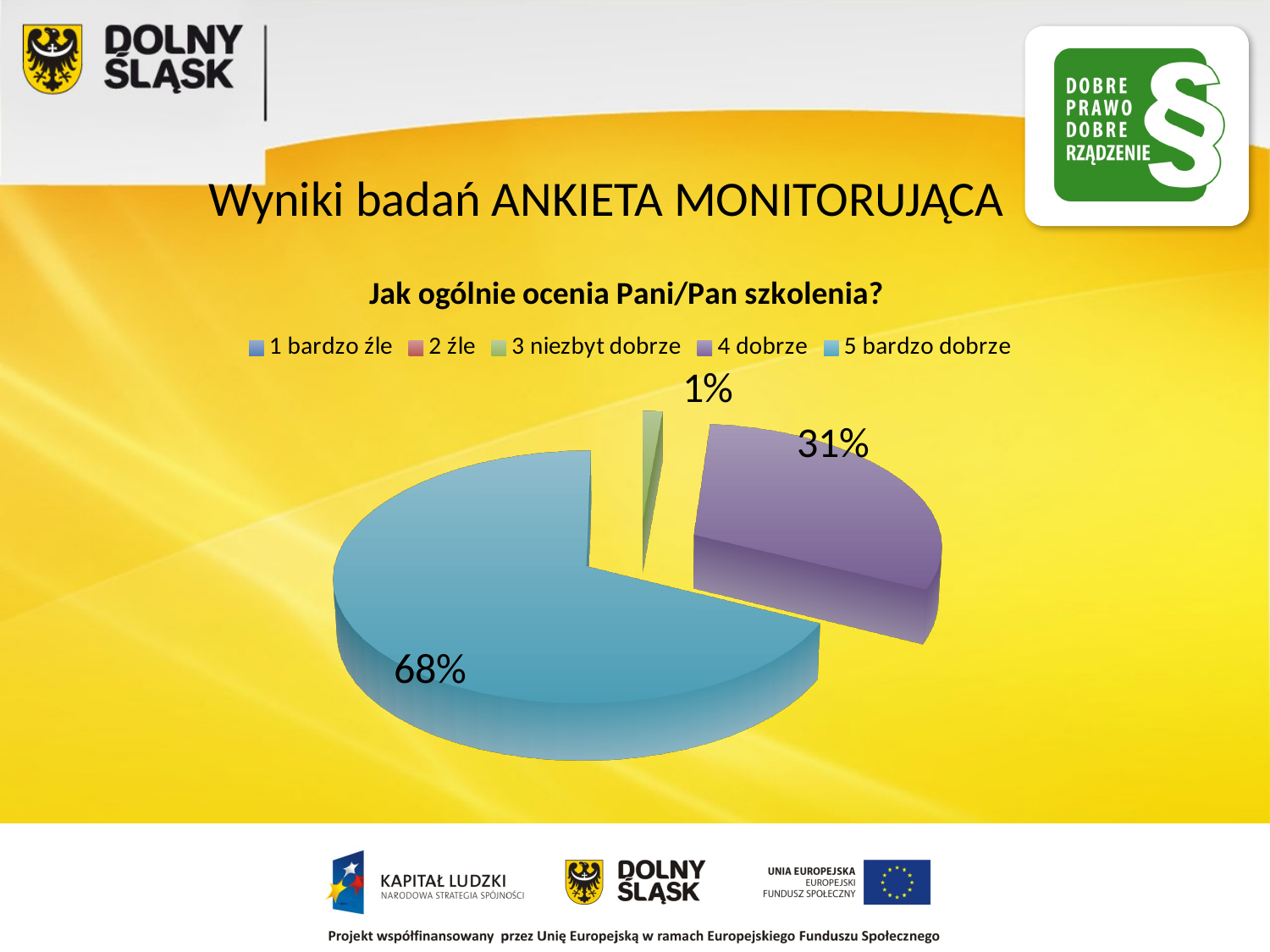
How many categories does the legend list? 5 Which slice is larger: '4 dobrze' or '3 niezbyt dobrze'? 4 dobrze What share of the pie is labelled for '5 bardzo dobrze'? 68% What is the chart's title? Jak ogólnie ocenia Pani/Pan szkolenia? Which category has the largest slice of the pie? 5 bardzo dobrze What kind of chart is shown on the slide? pie chart What colour is the slice for '5 bardzo dobrze'? blue What share of the pie is labelled for '3 niezbyt dobrze'? 1% What share of the pie is labelled for '4 dobrze'? 31% What is the difference in percentage points between the '5 bardzo dobrze' slice and the '4 dobrze' slice? 37 How many slices of the pie have a percentage label? 3 Which of the labelled slices is the smallest? 3 niezbyt dobrze